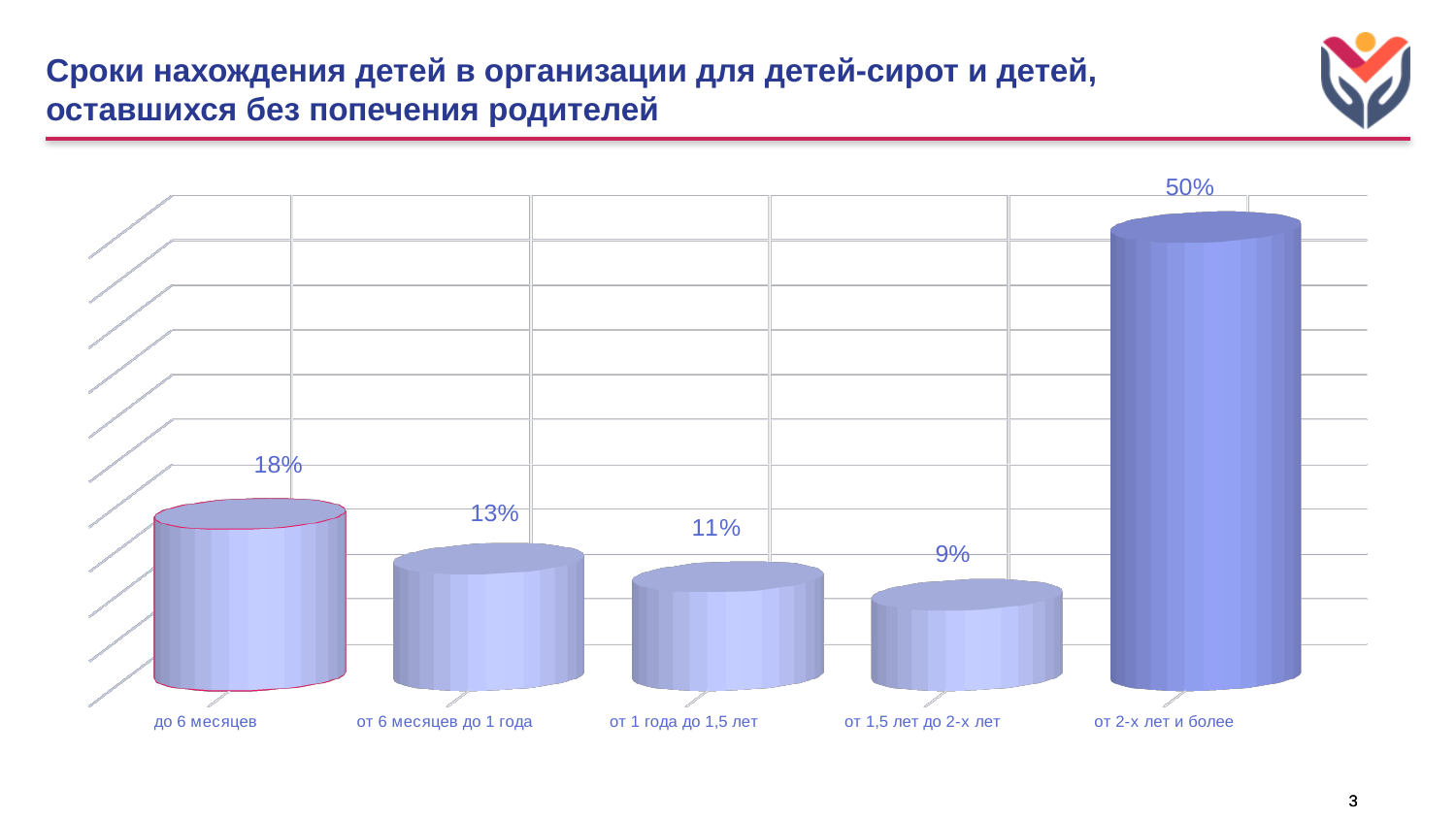
What is the value for the category 'от 1,5 лет до 2-х лет'? 9% What kind of chart is shown on the slide? bar chart What is the difference between the values for 'от 2-х лет и более' and 'до 6 месяцев'? 32% Which category has the highest value? от 2-х лет и более What is the value for the category 'от 2-х лет и более'? 50% Which is larger: the value for 'до 6 месяцев' or the value for 'от 6 месяцев до 1 года'? до 6 месяцев Which category has the lowest value? от 1,5 лет до 2-х лет Do the values fall or rise from 'до 6 месяцев' to 'от 1,5 лет до 2-х лет'? fall What is the difference between the values for 'от 6 месяцев до 1 года' and 'от 1 года до 1,5 лет'? 2% What is the title of the slide? Сроки нахождения детей в организации для детей-сирот и детей, оставшихся без попечения родителей What is the value for the category 'до 6 месяцев'? 18% How many categories are shown on the chart? 5